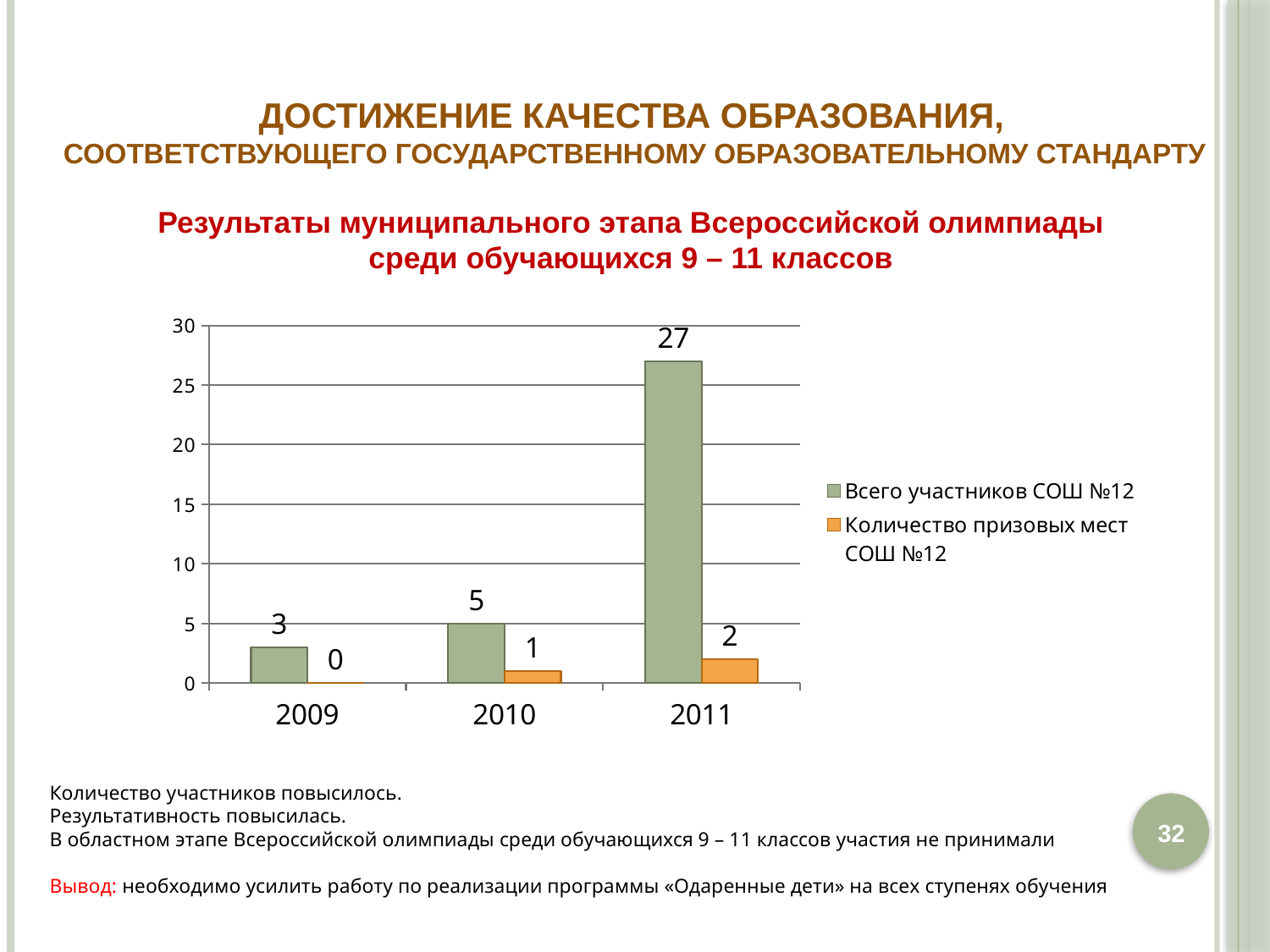
Does 'Всего участников СОШ №12' rise or fall from 2009 to 2011? rise What is the difference between 'Всего участников СОШ №12' in 2011 and in 2010? 22 What is the value for 'Количество призовых мест СОШ №12' in 2009? 0 What is the value for 'Количество призовых мест СОШ №12' in 2010? 1 How many years are shown on the x axis? 3 How many series does the legend list? 2 In which year is 'Количество призовых мест СОШ №12' lowest? 2009 Which is larger: 'Всего участников СОШ №12' in 2010 or 'Количество призовых мест СОШ №12' in 2011? Всего участников СОШ №12 in 2010 What is the value for 'Всего участников СОШ №12' in 2009? 3 What kind of chart is shown on the slide? bar chart In which year is 'Всего участников СОШ №12' highest? 2011 What is the value for 'Всего участников СОШ №12' in 2011? 27